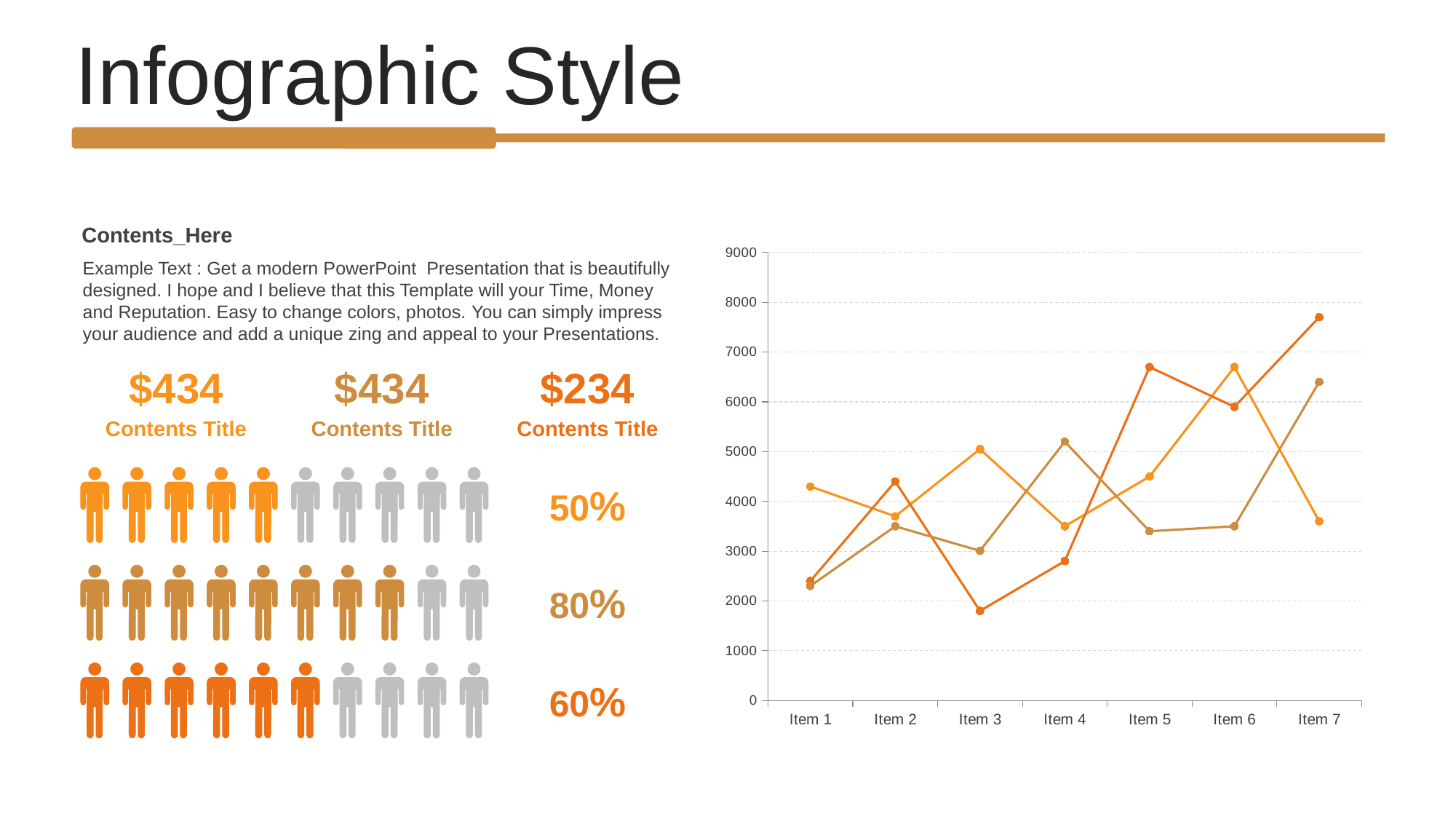
At which category does the line chart reach its highest point overall? Item 7 Is the highest value at Item 7 greater or less than 7000? greater Is the highest value at Item 5 greater or less than 6000? greater What is the highest value shown on the y axis of the line chart? 9000 Is the lowest value at Item 6 greater or less than 4000? less Does the light orange line rise or fall from Item 6 to Item 7? fall At which category does the line chart reach its lowest point overall? Item 3 How many categories are shown on the x axis of the line chart? 7 How many lines are plotted on the line chart? 3 What kind of chart is shown on the right side of the slide? line chart